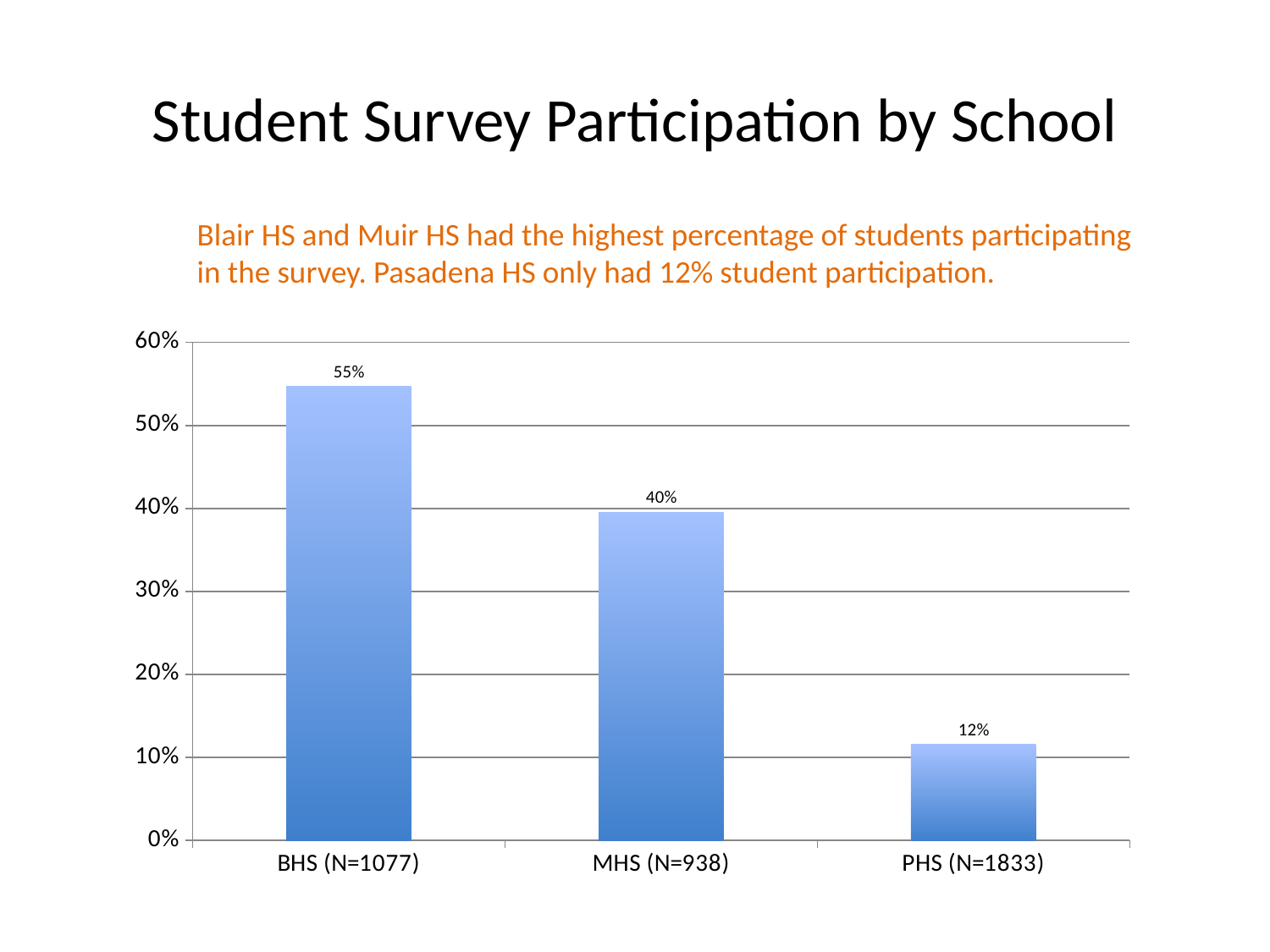
Do the participation percentages rise or fall from left to right across the schools? Fall Which has a higher participation percentage, MHS (N=938) or PHS (N=1833)? MHS (N=938) Which school has the highest survey participation percentage? BHS (N=1077) Is the participation percentage for BHS (N=1077) greater or less than 50%? greater What is the student survey participation percentage for BHS (N=1077)? 55% What type of chart is shown on the slide? Bar chart What is the difference in participation percentage between MHS (N=938) and PHS (N=1833)? 28% What is the difference in participation percentage between BHS (N=1077) and MHS (N=938)? 15% What is the student survey participation percentage for MHS (N=938)? 40% Which school has the lowest survey participation percentage? PHS (N=1833) What is the student survey participation percentage for PHS (N=1833)? 12% How many schools are shown in the chart? 3